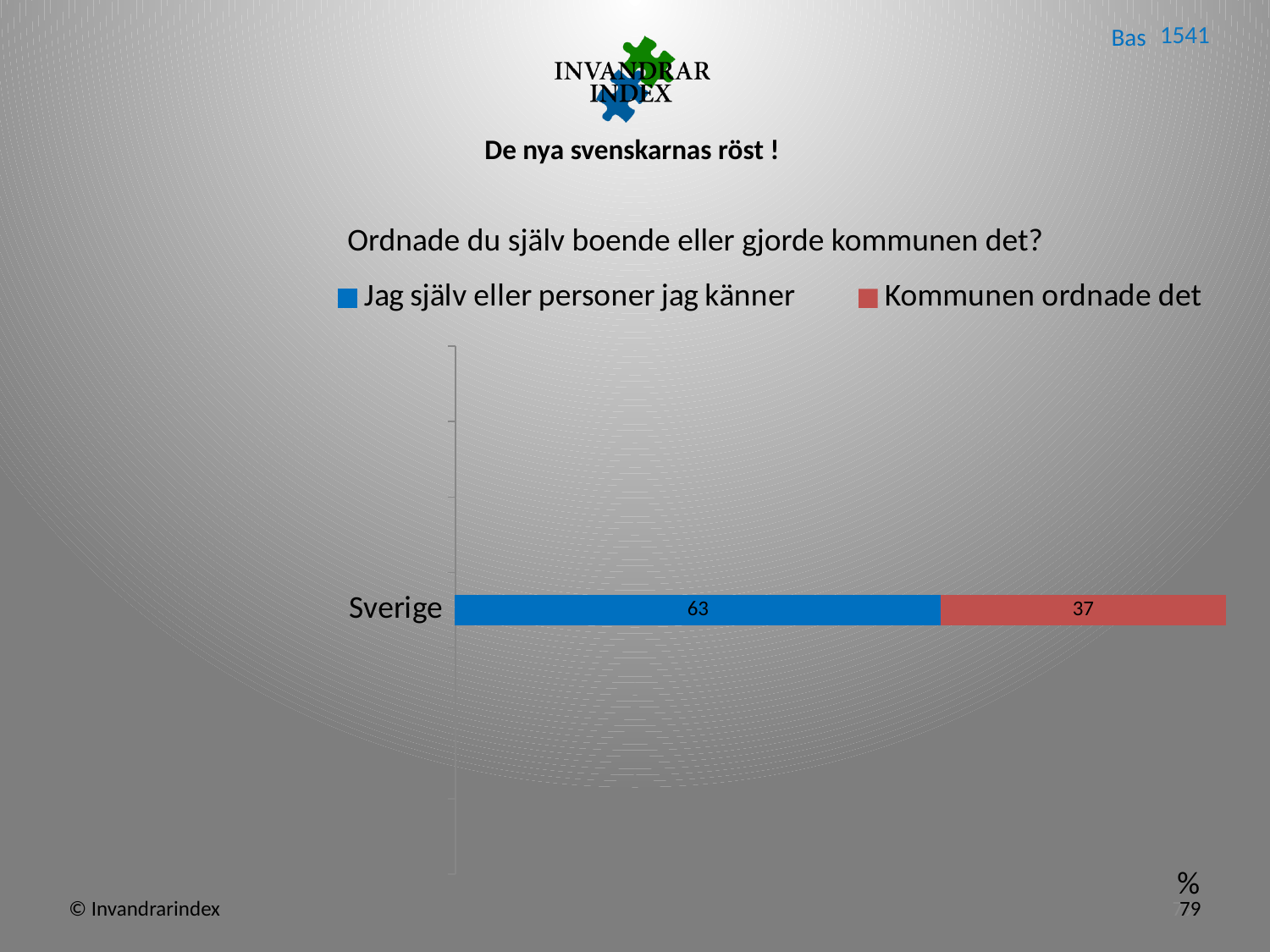
What is the value for "Jag själv eller personer jag känner" for Sverige? 63 What is the name of the only category on the chart? Sverige Which series has the larger value for Sverige, "Jag själv eller personer jag känner" or "Kommunen ordnade det"? Jag själv eller personer jag känner How many series does the legend list? 2 What is the difference between the "Jag själv eller personer jag känner" value and the "Kommunen ordnade det" value for Sverige? 26 What is the title of the chart? Ordnade du själv boende eller gjorde kommunen det? Which colour represents "Kommunen ordnade det" in the chart? Red How many categories are shown on the chart? 1 What kind of chart is shown on the slide? Stacked bar chart What is the value for "Kommunen ordnade det" for Sverige? 37 What is the total of the stacked bar for Sverige? 100